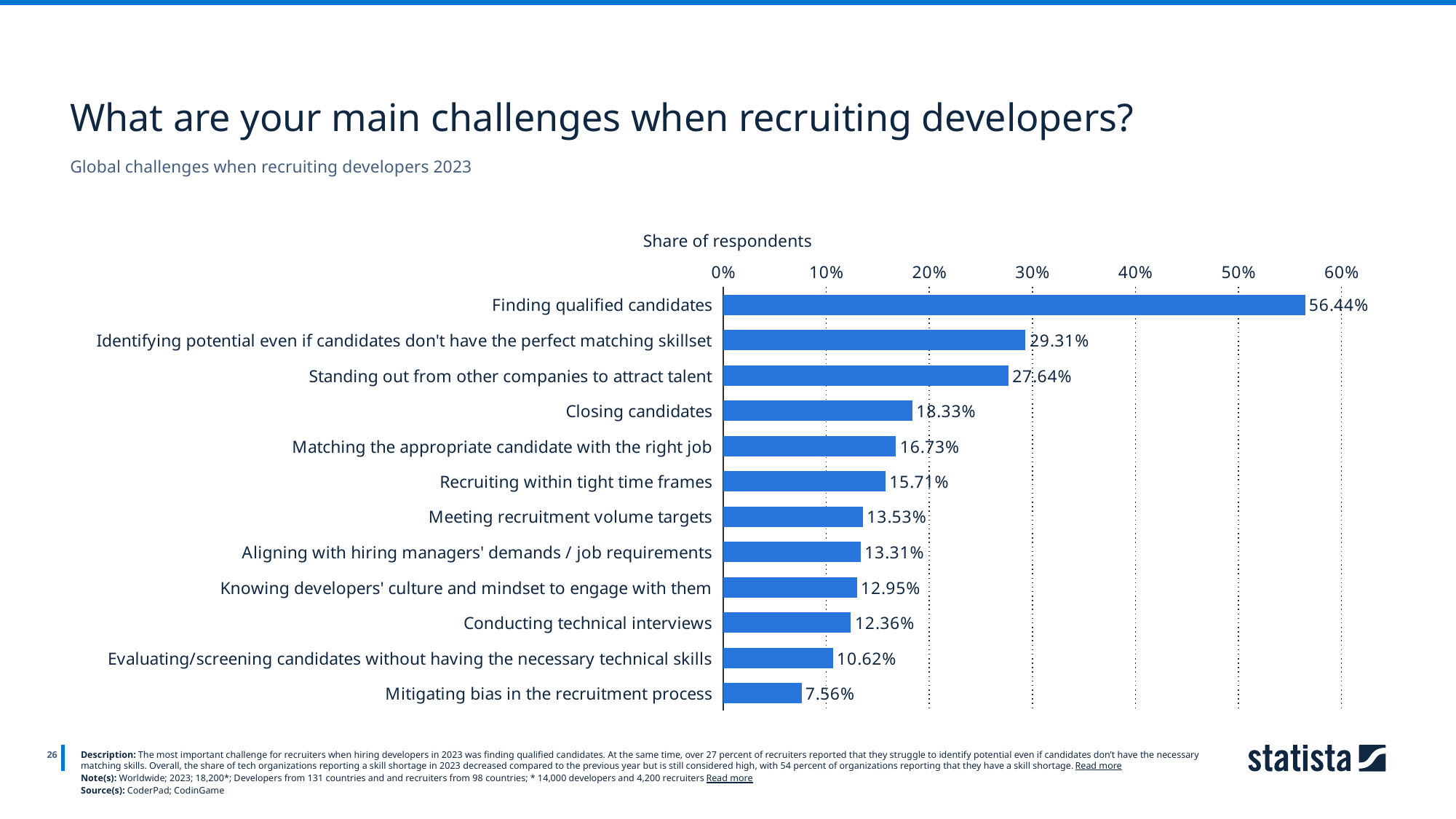
What is the label of the value axis at the top of the chart? Share of respondents What share of respondents cited conducting technical interviews? 12.36% What share of respondents cited finding qualified candidates as a main challenge? 56.44% Which challenge has the lowest share of respondents? Mitigating bias in the recruitment process How many challenges are shown in the chart? 12 What is the difference between the shares for closing candidates and mitigating bias in the recruitment process? 10.77% Which has a larger share: recruiting within tight time frames or meeting recruitment volume targets? Recruiting within tight time frames What kind of chart is shown on the slide? Bar chart Which challenge has the highest share of respondents? Finding qualified candidates What is the value for closing candidates? 18.33% What is the difference between the shares for finding qualified candidates and identifying potential even if candidates don't have the perfect matching skillset? 27.13% Is the value for standing out from other companies to attract talent greater or less than 30%? less